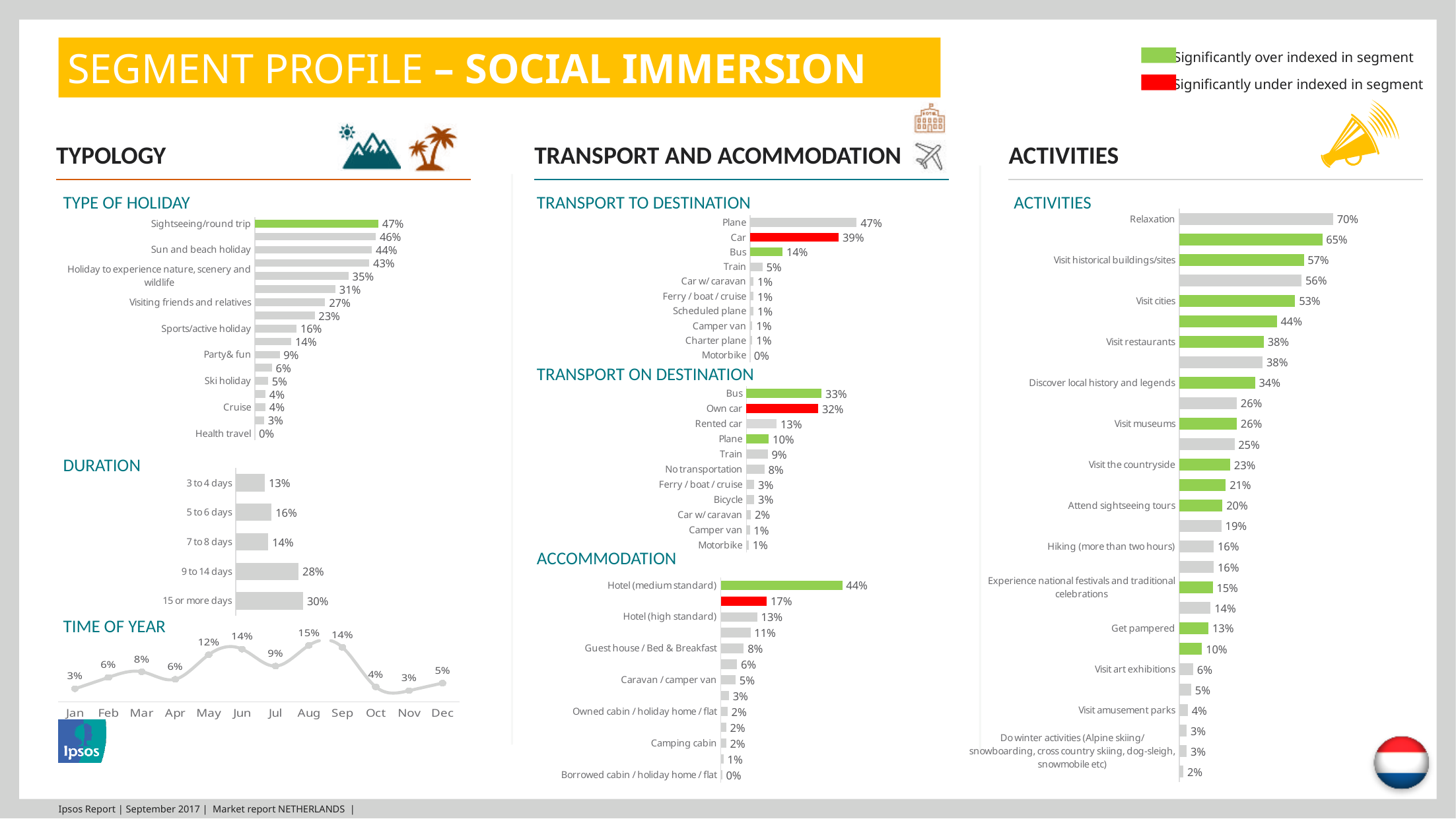
In the Duration chart, which duration category has the highest value? 15 or more days In the Time of Year chart, which month has the highest value? Aug In the Transport on Destination chart, which is larger, Bus or Rented car? Bus In the Transport to Destination chart, what is the value for Car? 39% In the Activities chart, what is the difference between Visit cities and Visit museums? 27% In the Activities chart, what is the value for Relaxation? 70% In the Transport to Destination chart, what is the difference between Plane and Bus? 33% In the Accommodation chart, what is the value for Hotel (medium standard)? 44% In the Duration chart, what is the value for 9 to 14 days? 28% What kind of chart is the Time of Year chart? Line chart How many categories are shown in the Duration chart? 5 In the Time of Year chart, what is the value for May? 12%